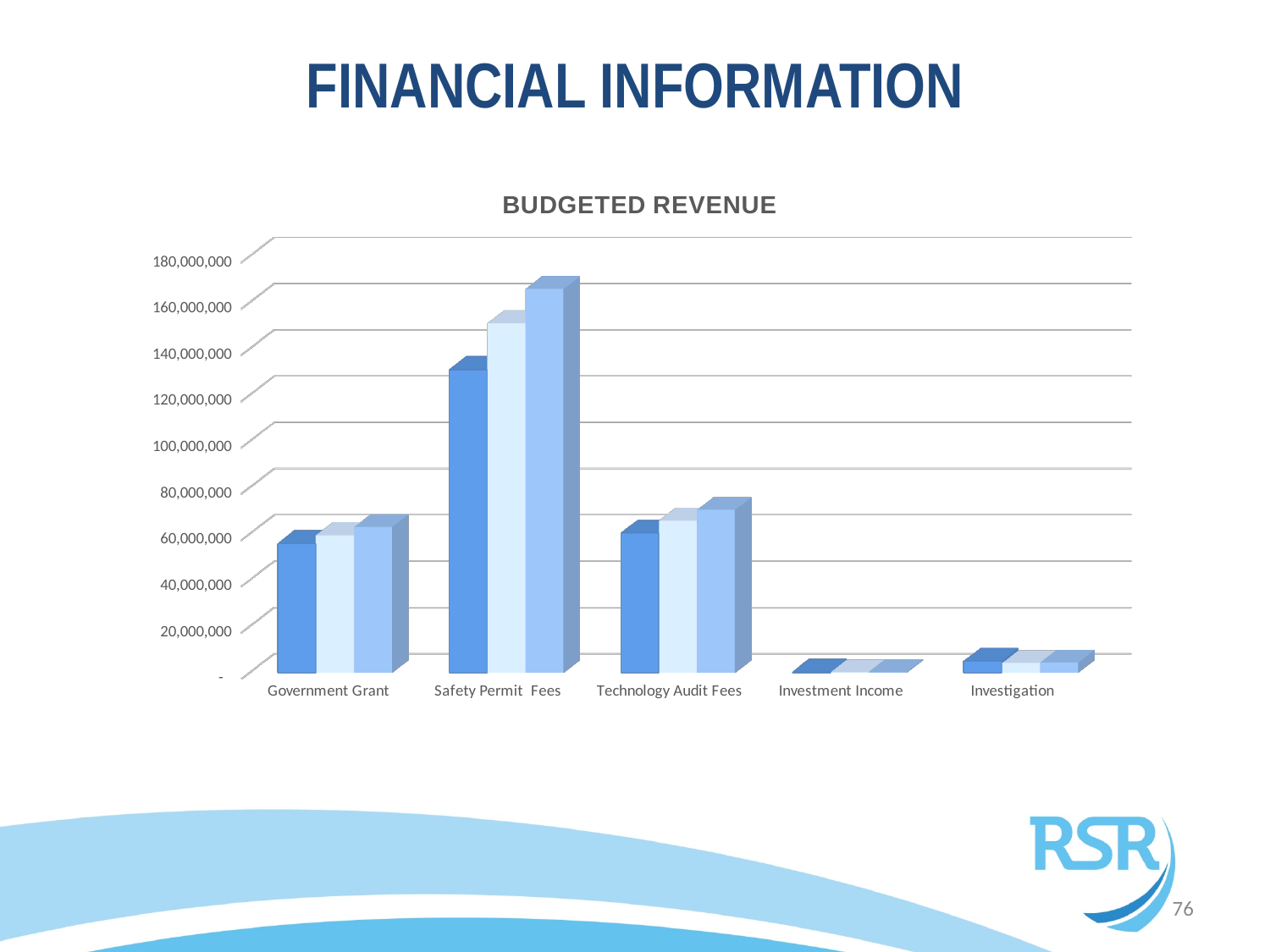
Which category has the highest budgeted revenue? Safety Permit Fees How many revenue categories are shown on the x axis? 5 Within the Safety Permit Fees group, do the three bars rise or fall from left to right? rise Are the bars for Government Grant greater or less than 40,000,000? greater Which category has larger bars, Safety Permit Fees or Technology Audit Fees? Safety Permit Fees What is the title of the chart? BUDGETED REVENUE Is the value of the tallest bar for Safety Permit Fees greater or less than 140,000,000? greater Are the bars for Investment Income greater or less than 20,000,000? less Which category has the lowest budgeted revenue? Investment Income How many bars are shown for each category? 3 What type of chart is shown on the slide? bar chart